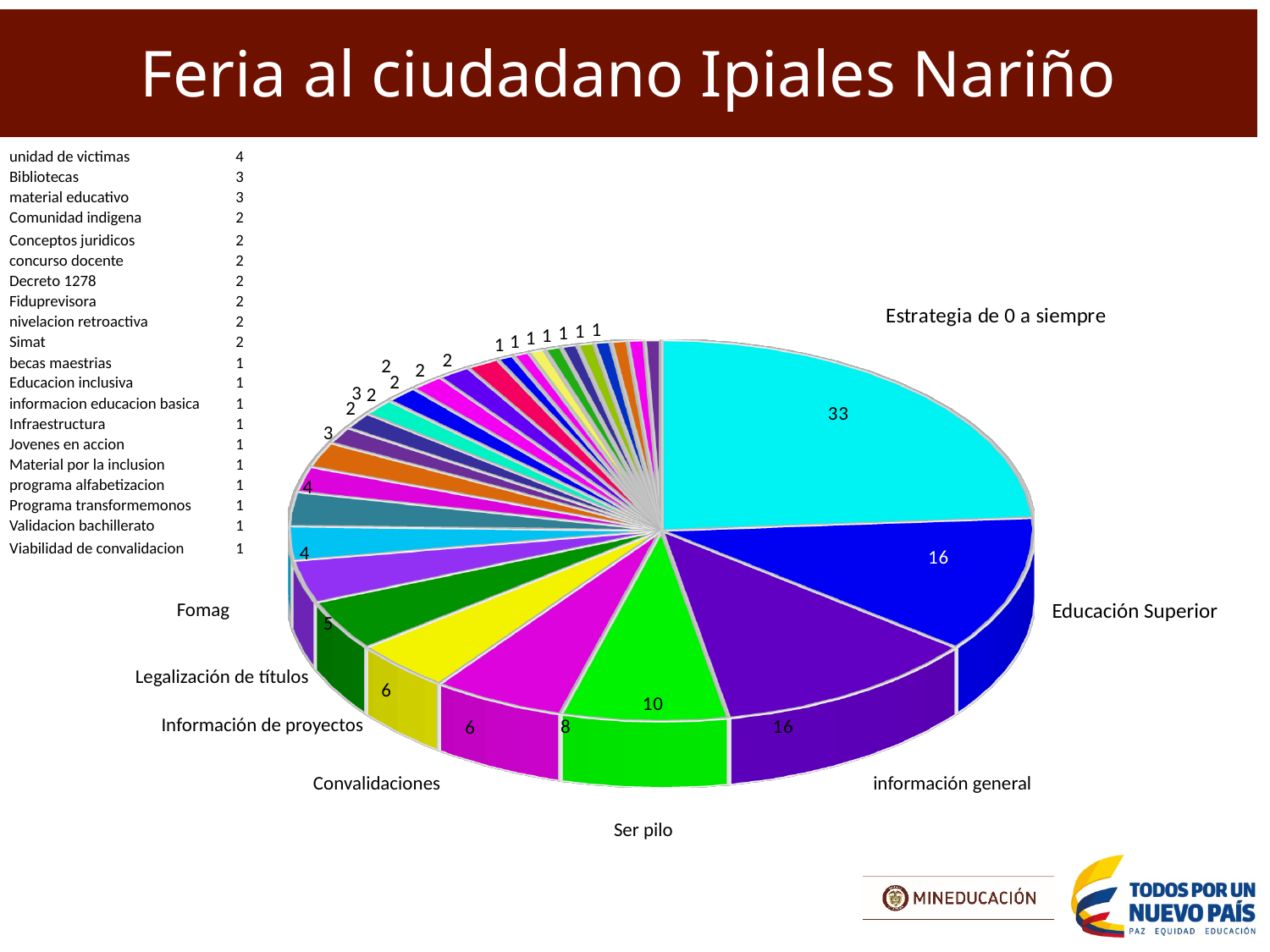
What is the value shown for Legalización de títulos? 6 Which category has the largest slice in the pie chart? Estrategia de 0 a siempre What type of chart is shown on the slide? Pie chart What is the difference between the values for Estrategia de 0 a siempre and Ser pilo? 23 What is the value shown for Ser pilo? 10 What is the value shown for Fomag? 5 What is the value shown for Estrategia de 0 a siempre? 33 What is the difference between the values for Educación Superior and Ser pilo? 6 Which is larger, the value for Ser pilo or the value for Convalidaciones? Ser pilo What is the title of the slide? Feria al ciudadano Ipiales Nariño What is the value shown for Educación Superior? 16 What is the value shown for Convalidaciones? 8